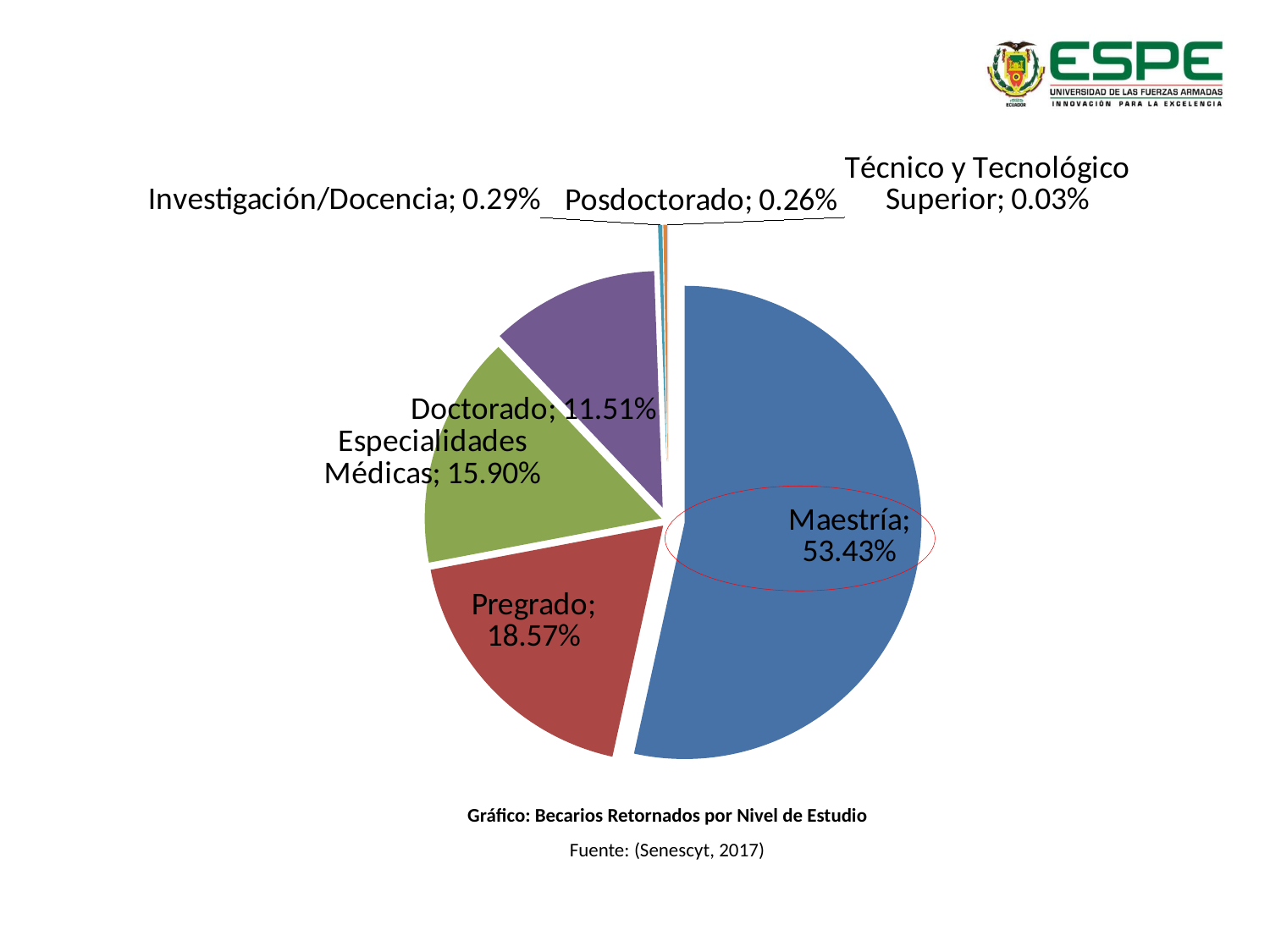
How many categories are shown in the pie chart? 7 What share of the pie does Maestría represent? 53.43% What is the value shown for Pregrado? 18.57% What is the difference between the Pregrado and Doctorado percentages? 7.06% What is the value shown for Especialidades Médicas? 15.90% Which category has the smallest slice of the pie? Técnico y Tecnológico Superior What is the value shown for Técnico y Tecnológico Superior? 0.03% What kind of chart is shown on the slide? Pie chart What is the value shown for Doctorado? 11.51% What is the title of the chart? Gráfico: Becarios Retornados por Nivel de Estudio Which is larger, Investigación/Docencia or Posdoctorado? Investigación/Docencia Which category has the largest slice of the pie? Maestría